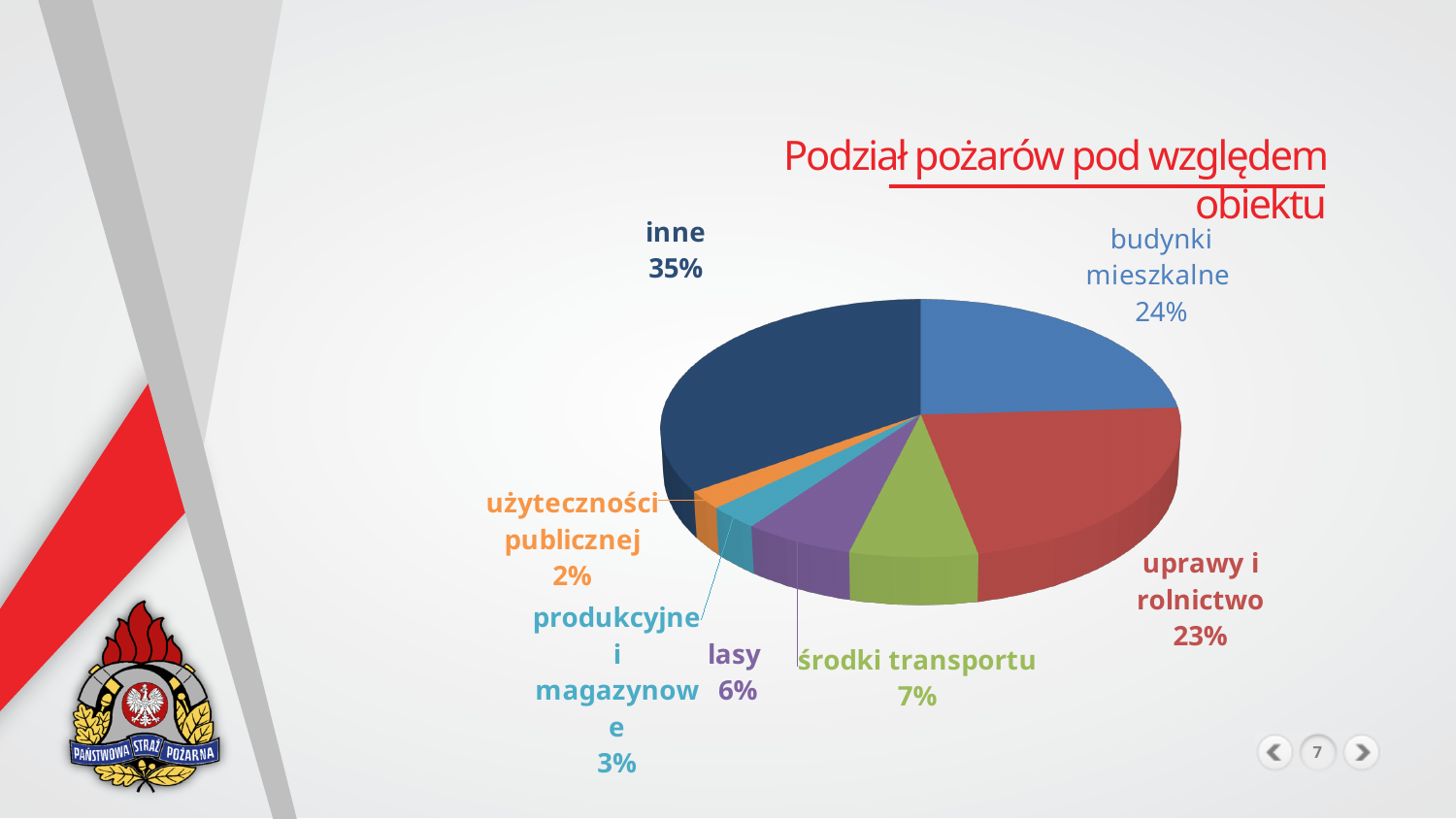
What share of the pie does "środki transportu" have? 7% What share of the pie does "inne" have? 35% Which category has the smallest slice of the pie? użyteczności publicznej What share of the pie does "uprawy i rolnictwo" have? 23% What is the difference in percentage points between "inne" and "budynki mieszkalne"? 11 What is the title of the chart? Podział pożarów pod względem obiektu Which category has the largest slice of the pie? inne How many slices does the pie chart have? 7 What share of the pie does "budynki mieszkalne" have? 24% What share of the pie does "użyteczności publicznej" have? 2% What share of the pie does "lasy" have? 6% What kind of chart is shown on the slide? pie chart